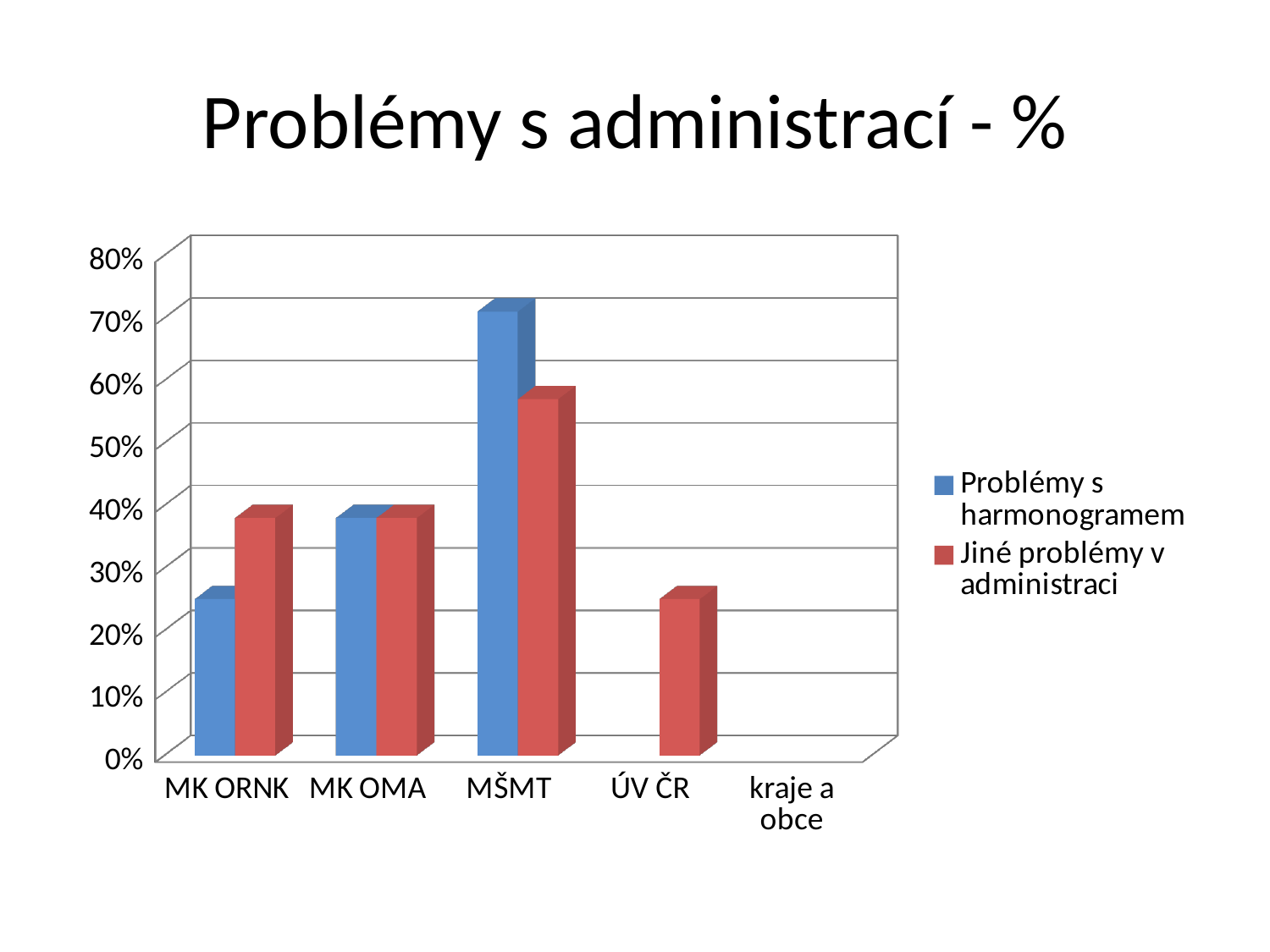
Is the value for 'Jiné problémy v administraci' at MŠMT greater or less than 50%? greater Which category has the highest value for 'Jiné problémy v administraci'? MŠMT Is the value for 'Problémy s harmonogramem' at MK ORNK greater or less than 30%? less For MK ORNK, which series has the larger value: 'Problémy s harmonogramem' or 'Jiné problémy v administraci'? Jiné problémy v administraci How many categories are shown on the x axis? 5 Is the value for 'Jiné problémy v administraci' at ÚV ČR greater or less than 30%? less What kind of chart is shown on the slide? bar chart Which category has the highest value for 'Problémy s harmonogramem'? MŠMT How many series does the legend list? 2 What is the title of the chart? Problémy s administrací - % For MŠMT, which series has the larger value: 'Problémy s harmonogramem' or 'Jiné problémy v administraci'? Problémy s harmonogramem